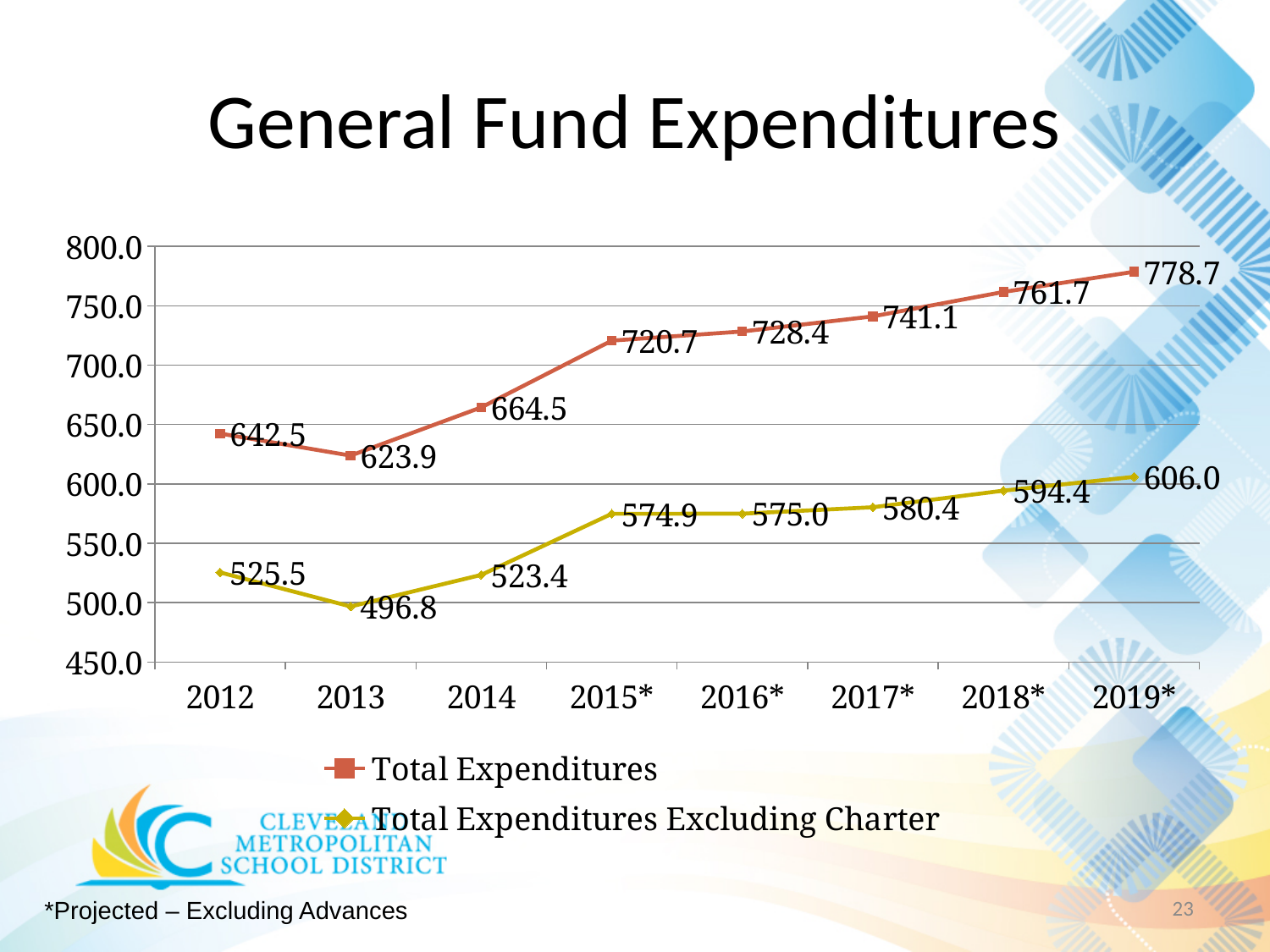
Which year has the highest Total Expenditures value? 2019* How many years are shown on the x axis? 8 What is the Total Expenditures value for 2012? 642.5 What is the difference between Total Expenditures and Total Expenditures Excluding Charter in 2019*? 172.7 Which year has the lowest Total Expenditures Excluding Charter value? 2013 What is the Total Expenditures value for 2016*? 728.4 What is the Total Expenditures Excluding Charter value for 2019*? 606.0 Which is larger: Total Expenditures in 2012 or Total Expenditures in 2013? 2012 Do the Total Expenditures values rise or fall from 2013 to 2019*? Rise What kind of chart is shown on the slide? Line chart What is the difference between Total Expenditures in 2014 and 2013? 40.6 How many series does the legend list? 2